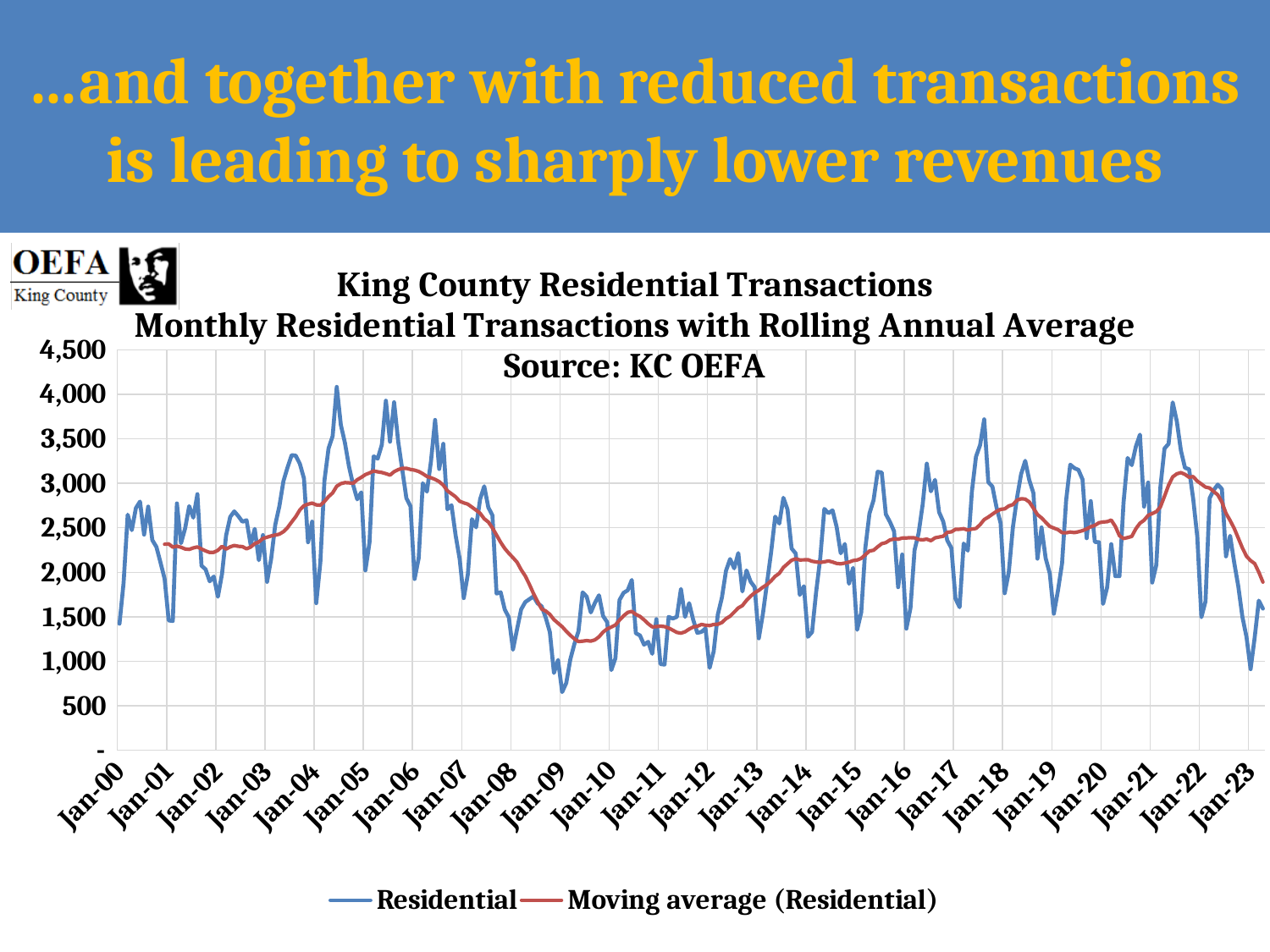
Which series is drawn in red? Moving average (Residential) Is the value of the Moving average (Residential) series at Jan-06 greater or less than 3,000? greater Which is larger for the Moving average (Residential) series: the value at Jan-06 or the value at Jan-11? Jan-06 Is the value of the Moving average (Residential) series at Jan-11 greater or less than 1,500? less How many year labels are shown on the x axis? 24 Is the lowest point of the Residential series, around 2009, greater or less than 1,000? less Does the Moving average (Residential) series rise or fall between Jan-06 and Jan-09? fall What kind of chart is shown on the slide? Line chart What is the title of the chart? King County Residential Transactions Monthly Residential Transactions with Rolling Annual Average Source: KC OEFA Does the Moving average (Residential) series rise or fall between Jan-12 and Jan-18? rise How many series does the legend list? 2